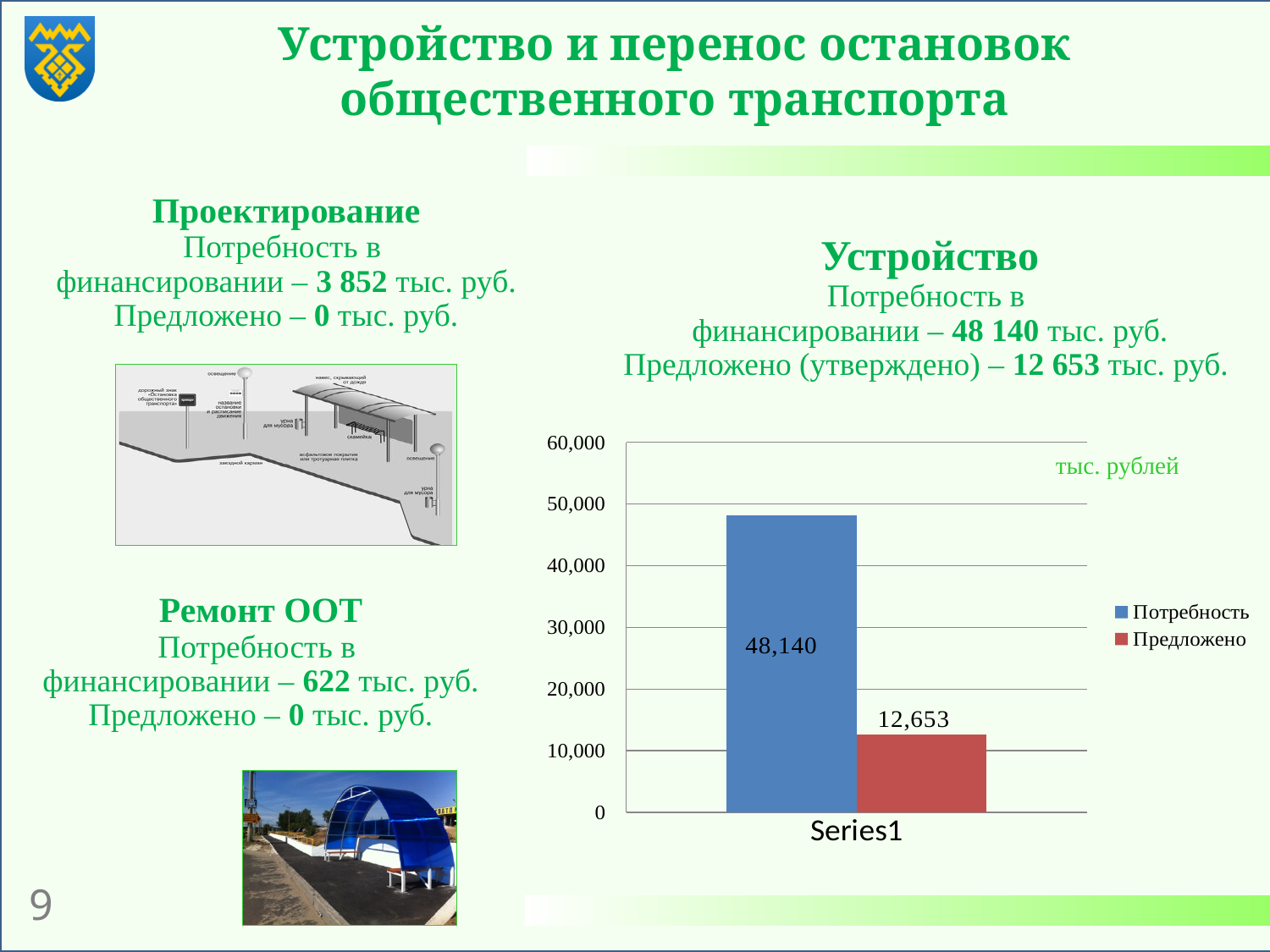
Which series has the higher value in the chart, Потребность or Предложено? Потребность What is the maximum value shown on the chart's y axis? 60,000 Is the value for Предложено greater or less than 20,000? less Which series has the lowest value in the chart? Предложено What is the category label shown on the x axis of the chart? Series1 What is the difference between the Потребность and Предложено values in the chart? 35,487 Is the value for Потребность greater or less than 40,000? greater What unit label is shown in the top right of the chart area? тыс. рублей How many series does the chart legend list? 2 What is the value of the Потребность bar in the chart? 48,140 What is the value of the Предложено bar in the chart? 12,653 What kind of chart is shown on the slide? bar chart